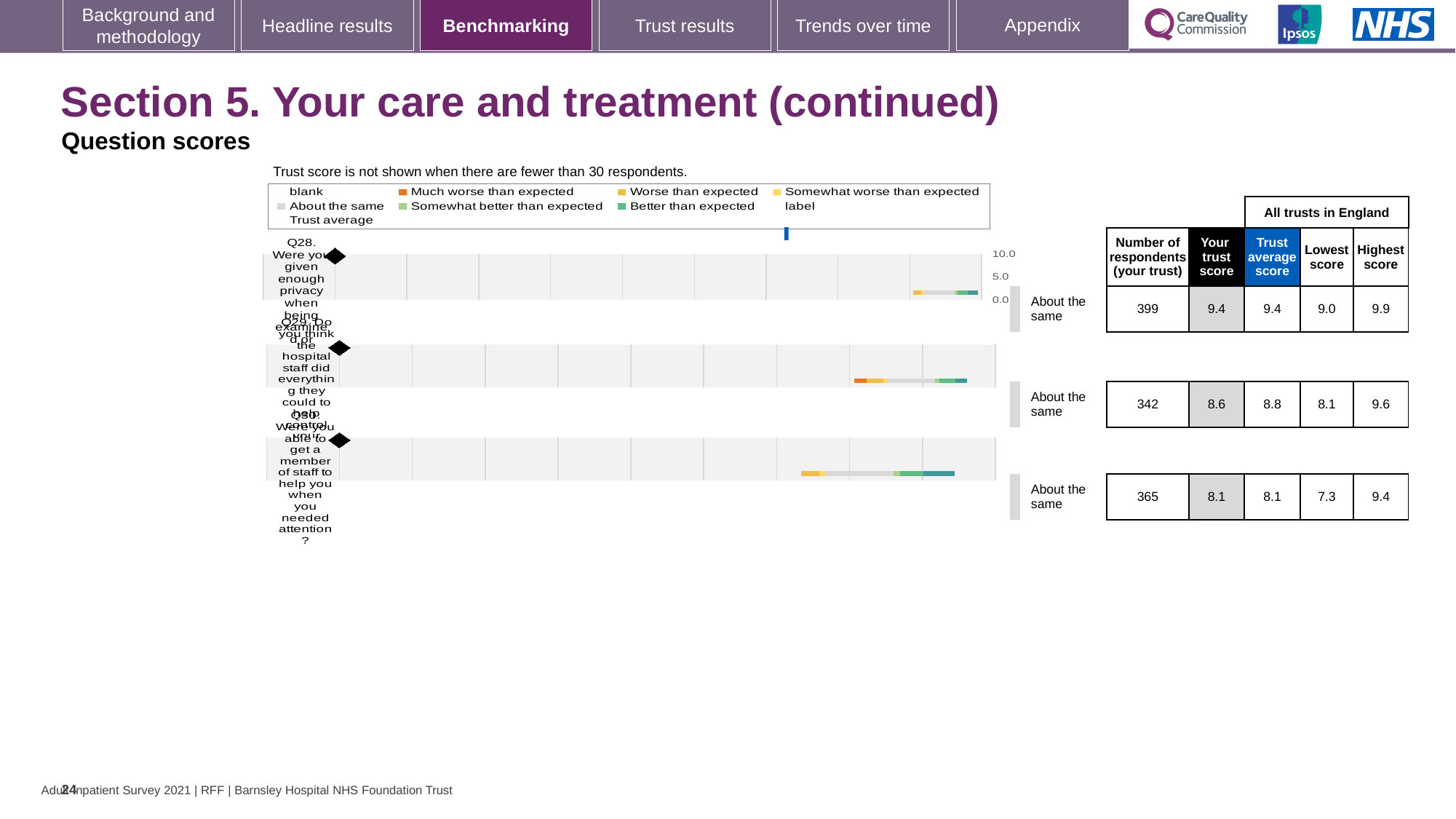
What is the trust score for Q30 (able to get a member of staff to help when you needed attention)? 8.1 How many respondents answered Q28 for this trust? 399 Is the trust score for Q28 larger or smaller than the trust score for Q30? larger Which of the three questions has the highest trust score? Q28 What is the difference between the trust score and the trust average score for Q29? 0.2 How many questions are plotted on this slide? 3 What benchmark category is shown for each of the three questions? About the same Which of the three questions has the lowest trust score? Q30 What is the lowest score across all trusts in England for Q29? 8.1 What is the highest score across all trusts in England for Q30? 9.4 What is the trust score for Q28 (privacy when being examined or treated)? 9.4 What is the trust score for Q29 (staff did everything to help control your pain)? 8.6